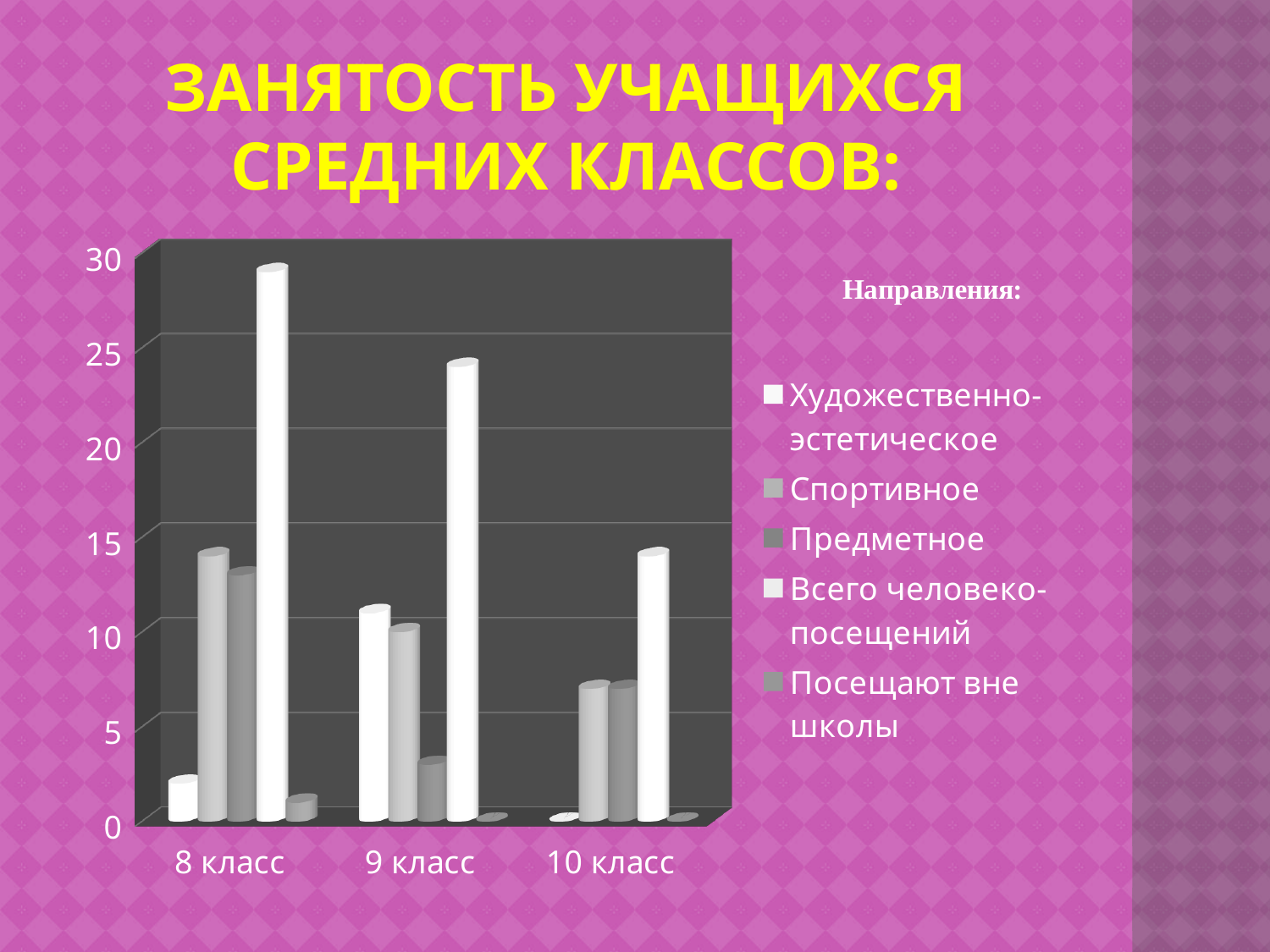
Is the value for Всего человеко-посещений in 8 класс greater or less than 25? greater What kind of chart is shown on the slide? bar chart Do the values for Всего человеко-посещений rise or fall from 8 класс to 10 класс? fall How many series does the legend list? 5 Is the value for Спортивное in 8 класс greater or less than 10? greater Which class has the lowest value for Всего человеко-посещений? 10 класс Is the value for Художественно-эстетическое in 8 класс greater or less than 5? less Which is larger: Художественно-эстетическое in 8 класс or in 9 класс? 9 класс What heading is shown above the legend? Направления: Which class has the highest value for Всего человеко-посещений? 8 класс How many class categories are shown on the x axis? 3